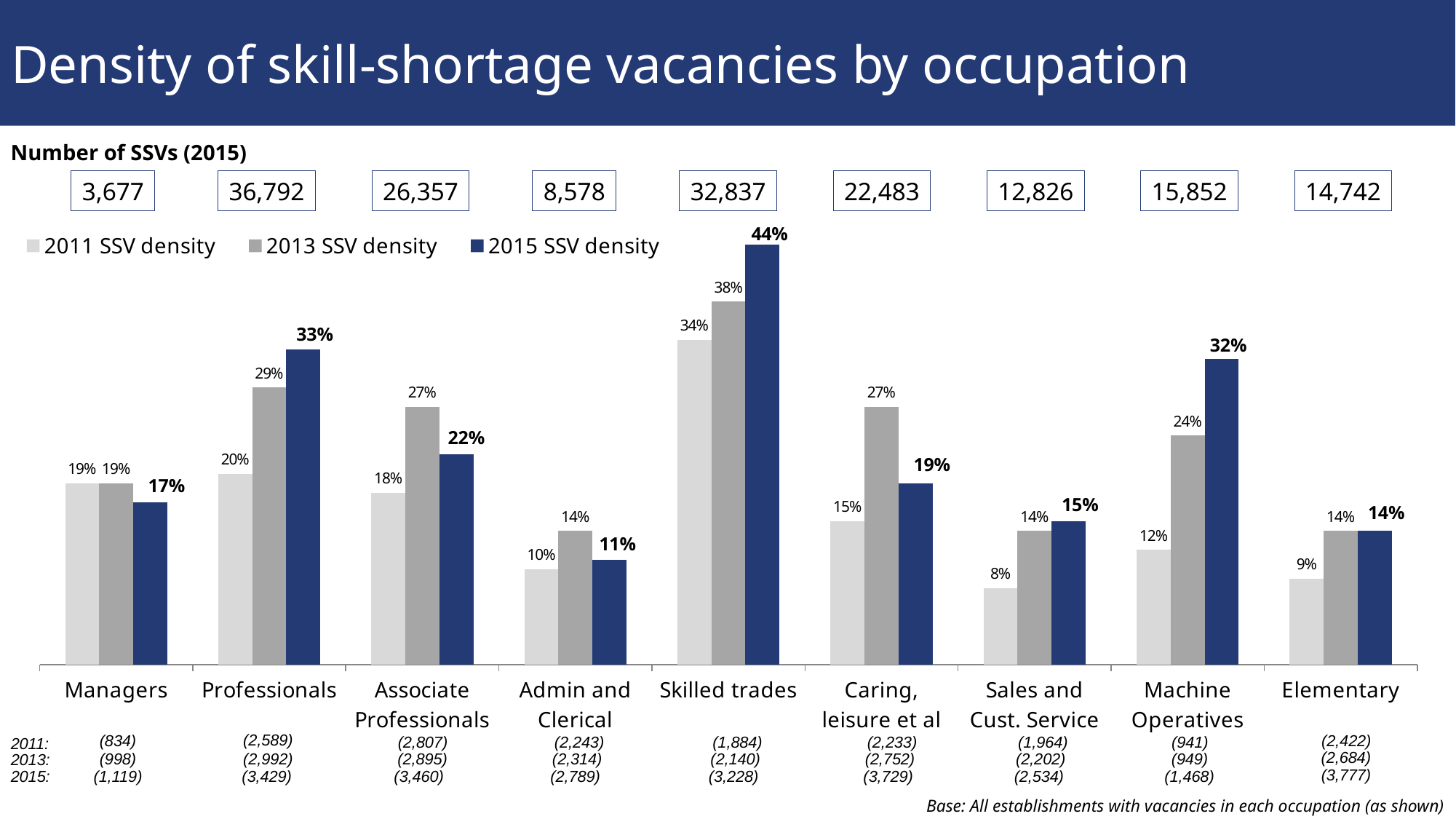
Does the SSV density for Admin and Clerical rise or fall from 2011 to 2013? Rise How many occupation categories are shown on the chart? 9 What is the difference between the 2015 and 2011 SSV density for Machine Operatives? 20% How many series does the legend list? 3 Which occupation has the lowest 2011 SSV density? Sales and Cust. Service What is the number of SSVs (2015) shown above the Professionals category? 36,792 What kind of chart is shown on the slide? Bar chart What is the 2015 SSV density for Skilled trades? 44% Which occupation has the highest 2015 SSV density? Skilled trades What is the 2013 SSV density for Professionals? 29% What is the 2011 SSV density for Sales and Cust. Service? 8% Which is larger for Managers: the 2013 SSV density or the 2015 SSV density? 2013 SSV density